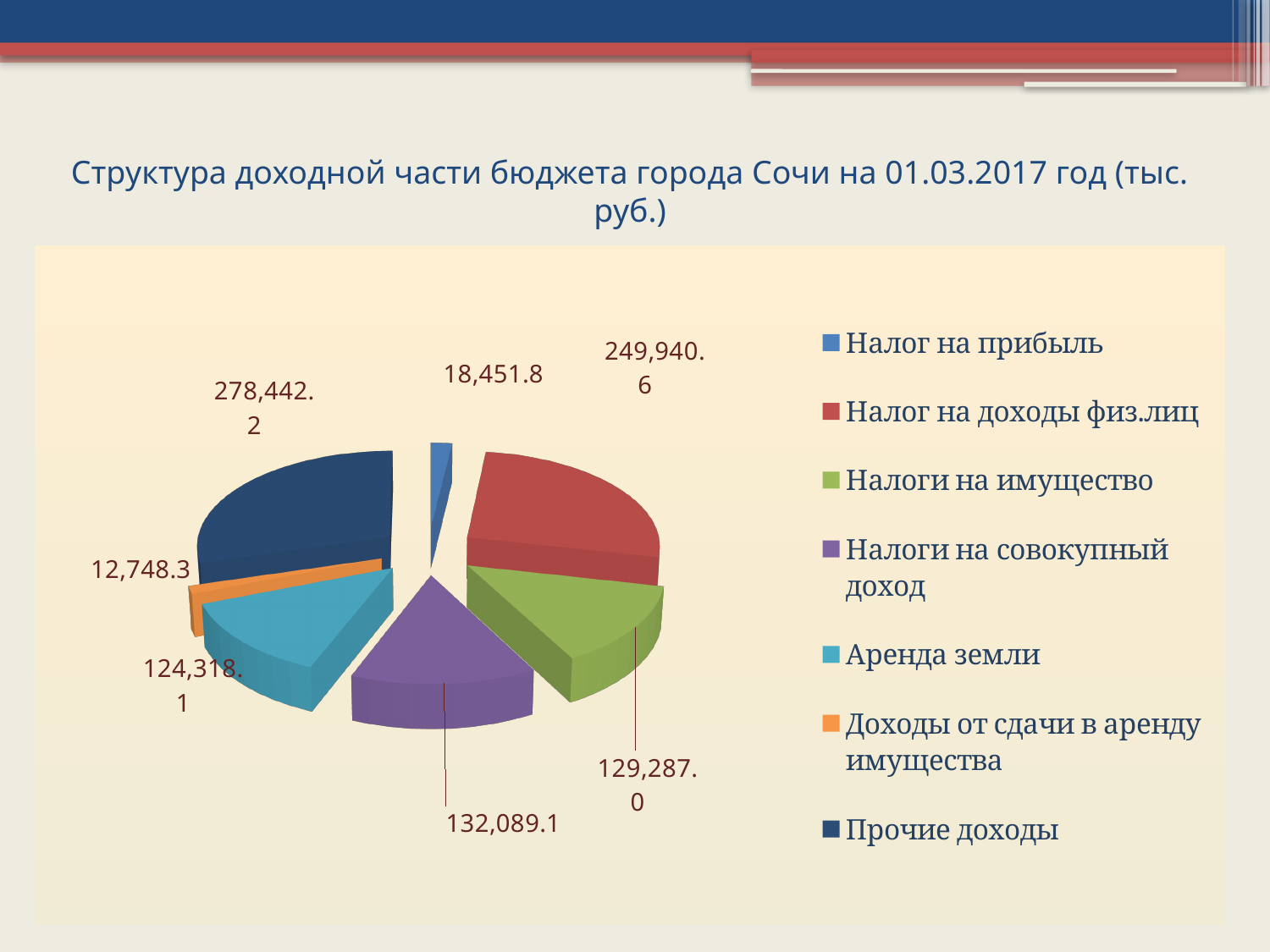
What colour is the slice for Аренда земли? Light blue (cyan) What type of chart is shown on the slide? Pie chart What is the value for Налог на прибыль? 18,451.8 How many categories does the pie chart show? 7 What is the value for Налог на доходы физ.лиц? 249,940.6 What is the value for Прочие доходы? 278,442.2 What is the difference between Налоги на совокупный доход and Налоги на имущество? 2,802.1 Which category has the smallest value? Доходы от сдачи в аренду имущества Which category has the largest value? Прочие доходы What is the value for Аренда земли? 124,318.1 What is the difference between Прочие доходы and Налог на доходы физ.лиц? 28,501.6 Which is larger: Налог на прибыль or Доходы от сдачи в аренду имущества? Налог на прибыль